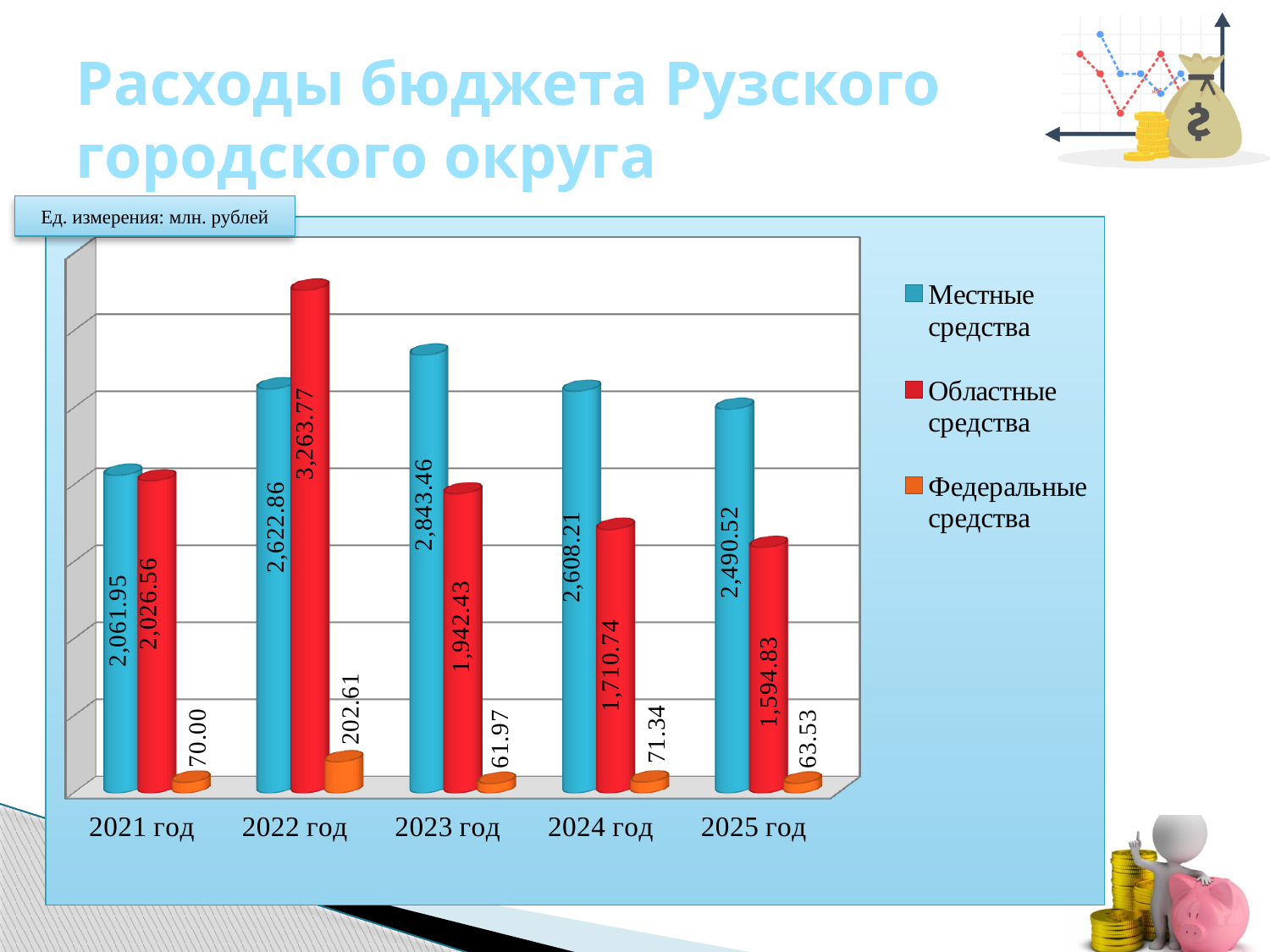
What kind of chart is shown on the slide? Bar chart In which year is the value for Федеральные средства the lowest? 2023 год In which year is the value for Областные средства the highest? 2022 год How many years are shown on the x axis? 5 What unit of measurement is stated for the chart? млн. рублей What is the value for Федеральные средства in 2021 год? 70.00 What is the value for Местные средства in 2023 год? 2,843.46 What is the difference between Областные средства and Местные средства in 2022 год? 640.91 Do the values for Областные средства rise or fall from 2022 год to 2025 год? Fall How many series does the legend list? 3 Which is larger in 2024 год: Местные средства or Областные средства? Местные средства What is the value for Областные средства in 2022 год? 3,263.77